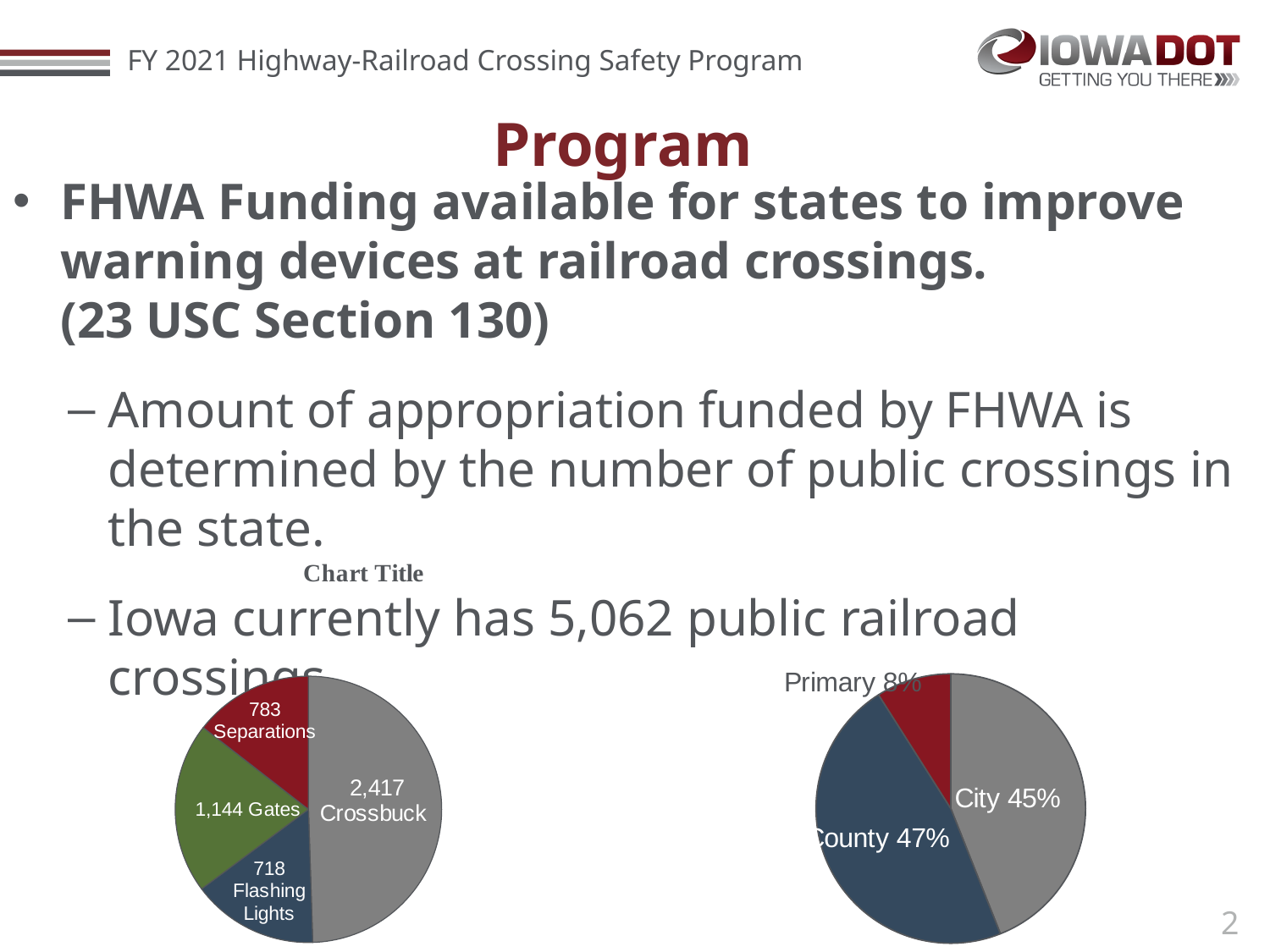
What type of chart is the right chart on the slide? Pie chart In the left pie chart, what is the difference between the Crossbuck value and the Gates value? 1,273 In the right pie chart, what share is labelled for County? 47% In the left pie chart, how many Crossbuck crossings are shown? 2,417 In the left pie chart, what is the value for Flashing Lights? 718 In the left pie chart, what is the value for Gates? 1,144 In the left pie chart, what is the total of all four slices? 5,062 In the left pie chart, which category has the largest slice? Crossbuck In the right pie chart, which is larger, City or County? County In the left pie chart, which category has the smallest slice? Flashing Lights How many categories does the left pie chart show? 4 In the right pie chart, what share is labelled for Primary? 8%